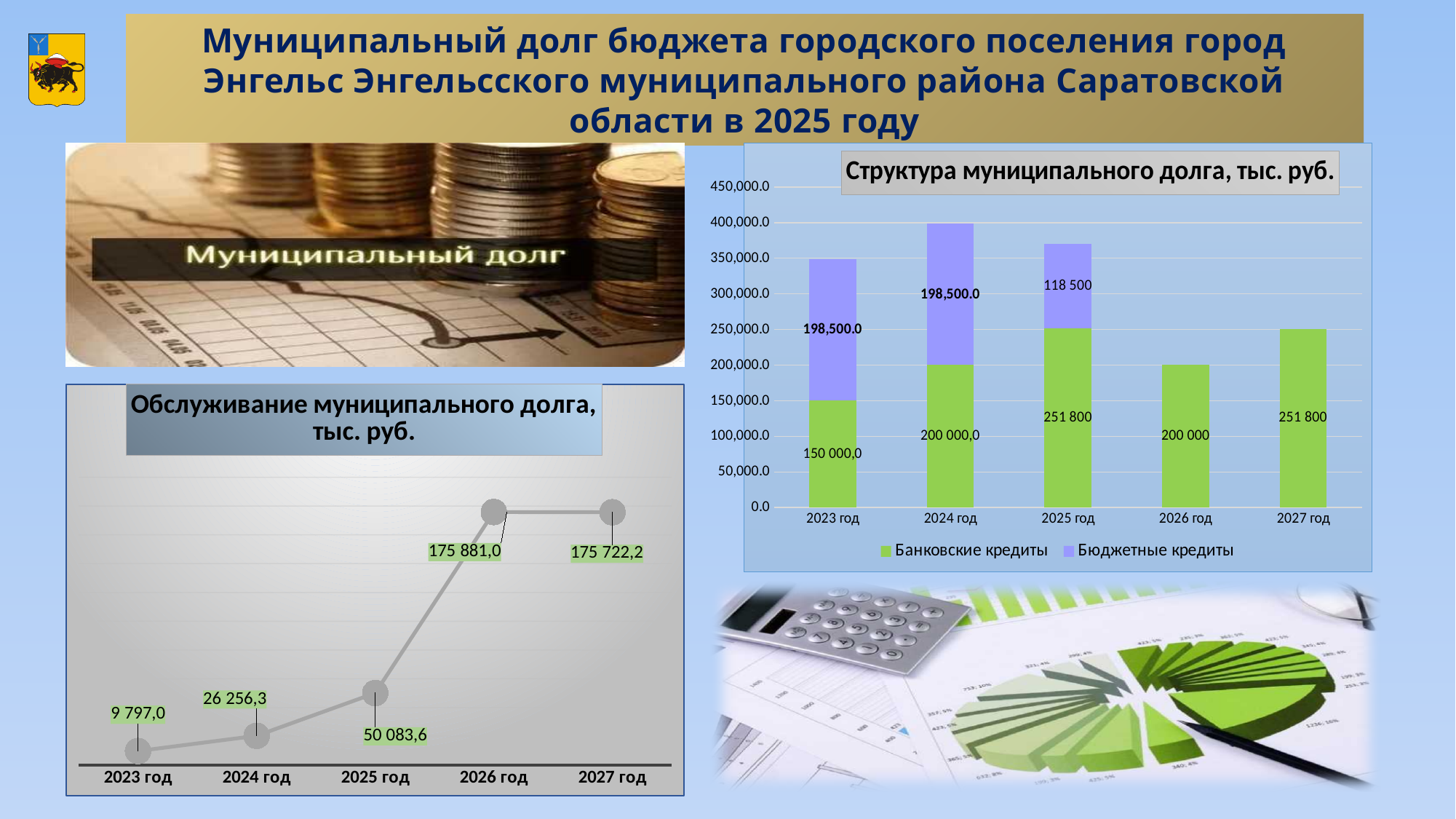
In the chart 'Обслуживание муниципального долга, тыс. руб.', what is the value for 2025 год? 50 083,6 In the chart 'Обслуживание муниципального долга, тыс. руб.', which year has the lowest value? 2023 год In the chart 'Обслуживание муниципального долга, тыс. руб.', what is the difference between the values for 2026 год and 2027 год? 158,8 In the chart 'Обслуживание муниципального долга, тыс. руб.', how many years are plotted? 5 In the chart 'Структура муниципального долга, тыс. руб.', what is the total of the stacked bar for 2025 год? 370 300 In the chart 'Обслуживание муниципального долга, тыс. руб.', what is the value for 2023 год? 9 797,0 In the chart 'Структура муниципального долга, тыс. руб.', is the value of Банковские кредиты for 2024 год larger or smaller than for 2025 год? smaller In the chart 'Структура муниципального долга, тыс. руб.', what is the value of Бюджетные кредиты for 2025 год? 118 500 In the chart 'Структура муниципального долга, тыс. руб.', what is the value of Банковские кредиты for 2025 год? 251 800 What kind of chart is 'Структура муниципального долга, тыс. руб.'? stacked bar chart In the chart 'Обслуживание муниципального долга, тыс. руб.', which year has the highest value? 2026 год In the chart 'Структура муниципального долга, тыс. руб.', how many series does the legend list? 2